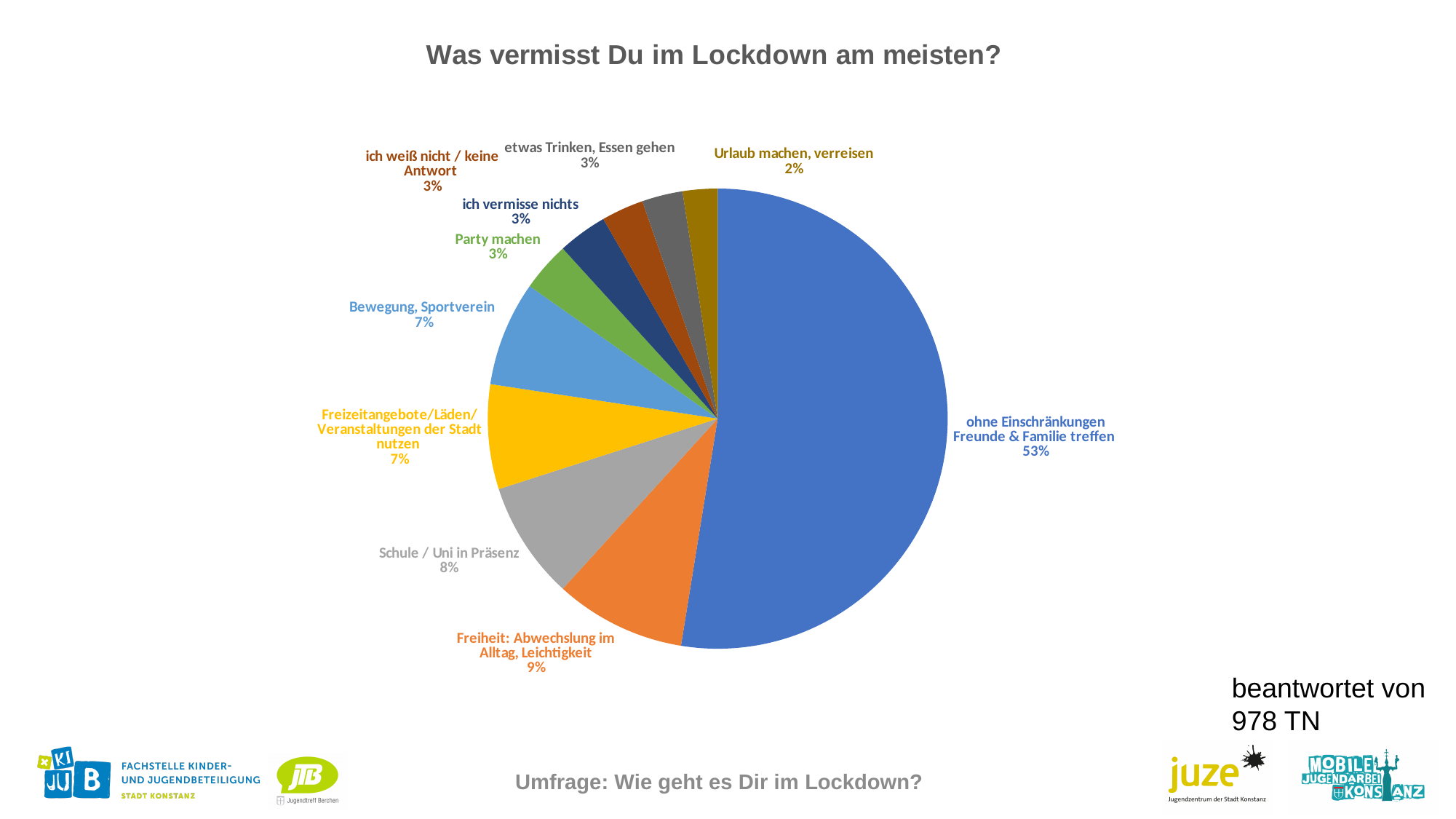
What is the difference in percentage points between 'ohne Einschränkungen Freunde & Familie treffen' and 'Freiheit: Abwechslung im Alltag, Leichtigkeit'? 44 What share of the pie is 'Schule / Uni in Präsenz'? 8% What share of the pie is 'Urlaub machen, verreisen'? 2% Which is larger, the share for 'Schule / Uni in Präsenz' or the share for 'Party machen'? Schule / Uni in Präsenz What share of the pie is 'ohne Einschränkungen Freunde & Familie treffen'? 53% Which category has the largest share of the pie? ohne Einschränkungen Freunde & Familie treffen How many categories (slices) does the pie chart have? 10 Which category has the smallest share of the pie? Urlaub machen, verreisen What kind of chart is shown on the slide? pie chart What is the title of the chart? Was vermisst Du im Lockdown am meisten?